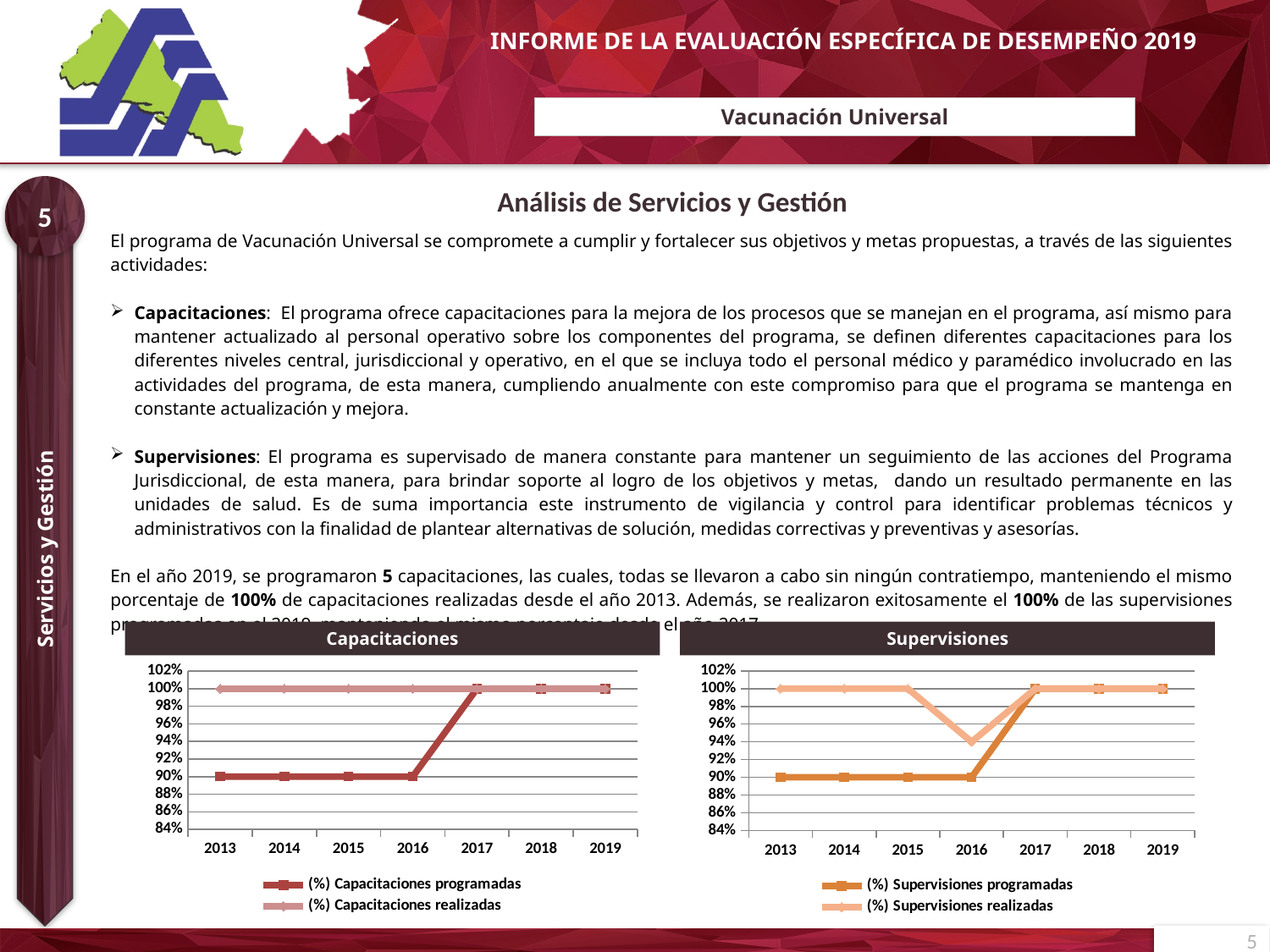
In the 'Supervisiones' chart, which series has the higher value in 2014, '(%) Supervisiones programadas' or '(%) Supervisiones realizadas'? (%) Supervisiones realizadas What kind of chart is the 'Capacitaciones' chart? line chart In the 'Capacitaciones' chart, does '(%) Capacitaciones programadas' rise or fall from 2016 to 2017? rise What is the title of the chart on the right side of the slide? Supervisiones In the 'Supervisiones' chart, what is the value of '(%) Supervisiones programadas' in 2016? 90% In the 'Capacitaciones' chart, what is the value of '(%) Capacitaciones programadas' in 2013? 90% In the 'Capacitaciones' chart, what is the value of '(%) Capacitaciones realizadas' in 2015? 100% In the 'Supervisiones' chart, in which year is '(%) Supervisiones realizadas' at its lowest? 2016 In the 'Capacitaciones' chart, what is the value of '(%) Capacitaciones programadas' in 2019? 100% How many years are shown on the x axis of the 'Capacitaciones' chart? 7 How many series does the legend of the 'Supervisiones' chart list? 2 In the 'Supervisiones' chart, is the value of '(%) Supervisiones realizadas' in 2016 greater or less than 96%? less